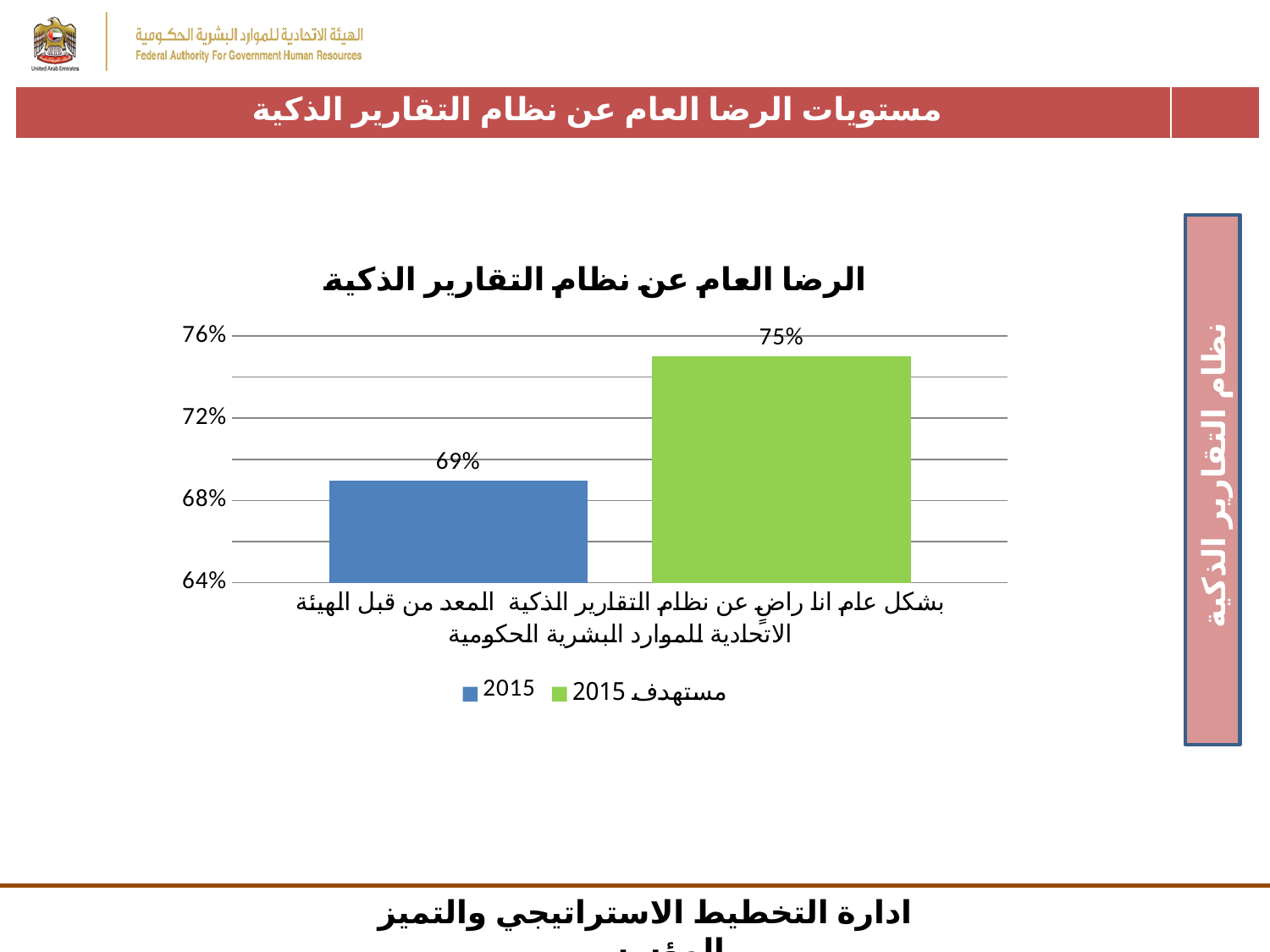
What is the title of the chart? الرضا العام عن نظام التقارير الذكية How many series does the legend list? 2 Which series has the higher value, 2015 or مستهدف 2015? مستهدف 2015 What is the value for the 2015 series in the chart? 69% What is the difference between the مستهدف 2015 value and the 2015 value? 6% What kind of chart is shown on the slide? Bar chart Is the value for the 2015 series greater or less than 72%? less Is the value for the مستهدف 2015 series greater or less than 72%? greater What is the value for the مستهدف 2015 (target 2015) series in the chart? 75% What colour is the bar for the مستهدف 2015 series? Green Which series shows the lowest value in the chart? 2015 How many bars are plotted in the chart? 2